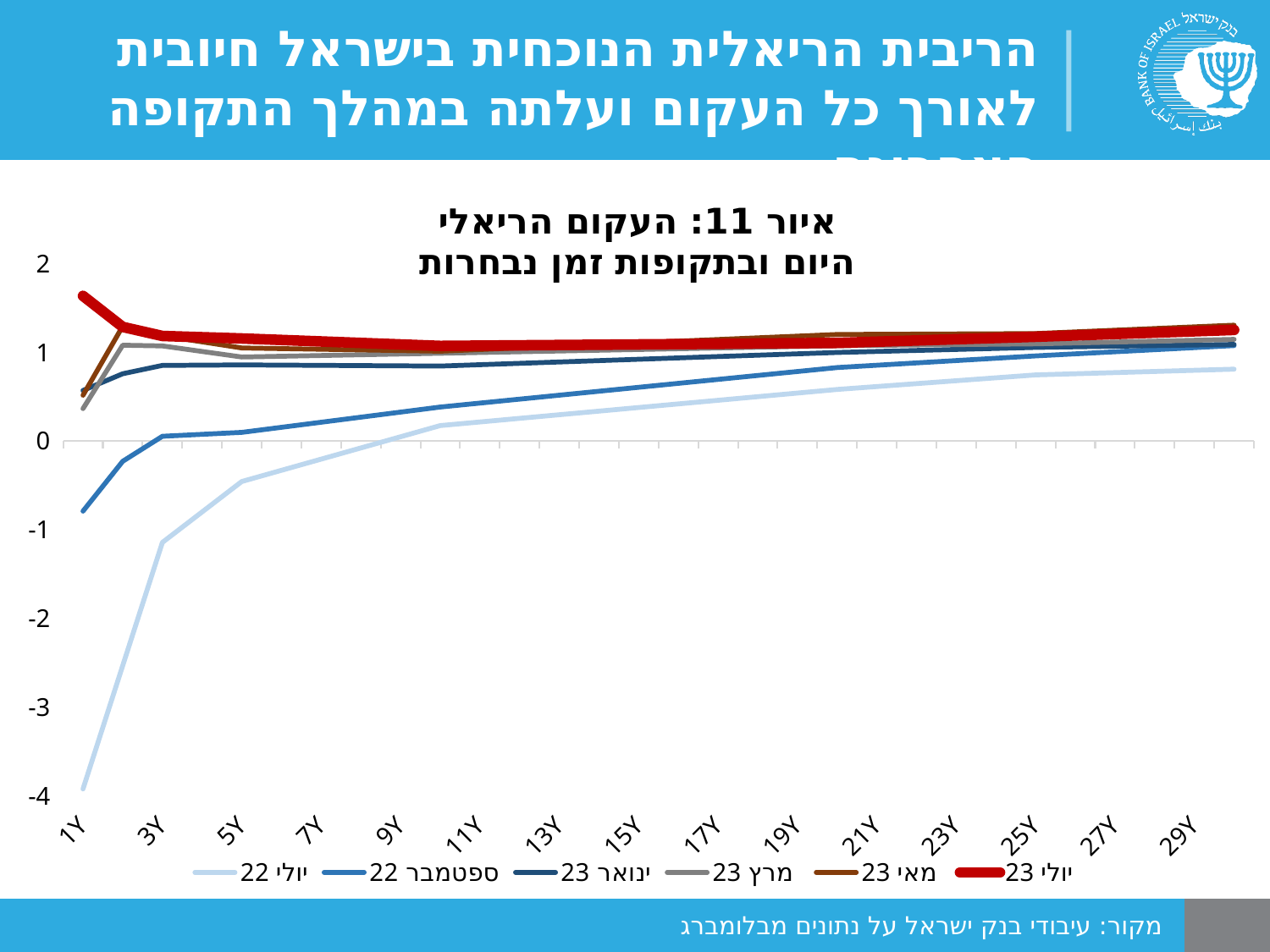
How many maturity labels are shown on the x axis? 15 Is the value of the יולי 23 series at 1Y greater or less than 1? greater Does the יולי 22 series rise or fall as the maturity increases along the x axis? rise How many series does the legend list? 6 Which series has the lowest value at 1Y? יולי 22 Is the value of the ספטמבר 22 series at 1Y greater or less than -1? greater What kind of chart is shown on the slide? line chart What colour is the line for the יולי 23 series? red Which series has the highest value at 1Y? יולי 23 What is the title of the chart? איור 11: העקום הריאלי היום ובתקופות זמן נבחרות Is the value of the יולי 22 series at 1Y greater or less than -3? less At 1Y, which is larger: the יולי 23 series or the יולי 22 series? יולי 23